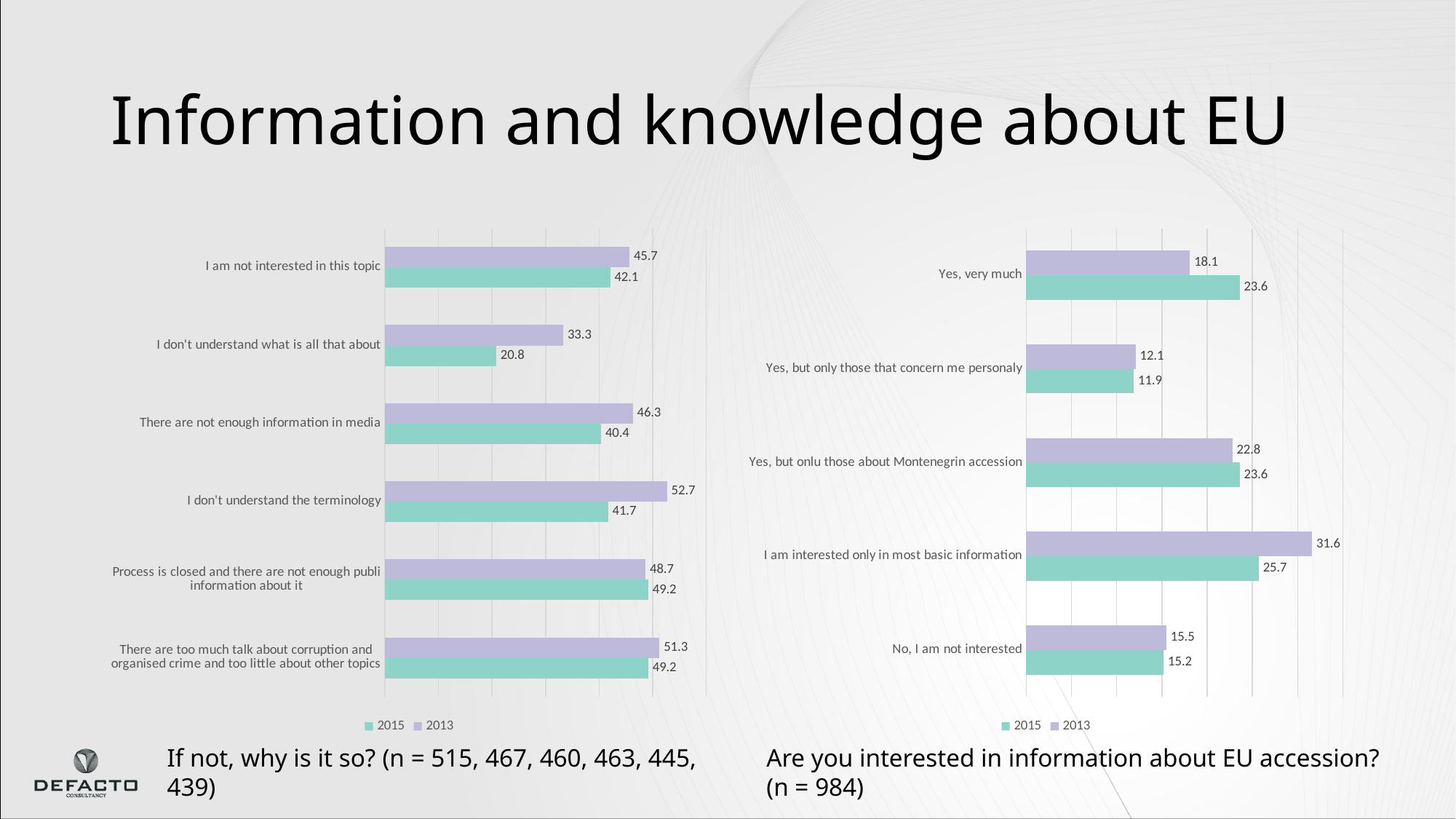
In the left chart (If not, why is it so?), which category has the lowest 2015 value? I don't understand what is all that about In the right chart (Are you interested in information about EU accession?), what is the 2015 value for "No, I am not interested"? 15.2 In the left chart (If not, why is it so?), what is the 2013 value for "I don't understand the terminology"? 52.7 How many series does the legend of the right chart (Are you interested in information about EU accession?) list? 2 In the right chart (Are you interested in information about EU accession?), which is larger for "Yes, very much": the 2013 value or the 2015 value? 2015 In the left chart (If not, why is it so?), how many categories are shown? 6 In the left chart (If not, why is it so?), what is the 2015 value for "I don't understand what is all that about"? 20.8 In the right chart (Are you interested in information about EU accession?), what is the difference between the 2013 and 2015 values for "I am interested only in most basic information"? 5.9 In the left chart (If not, why is it so?), which category has the highest 2013 value? I don't understand the terminology What type of chart is the left chart (If not, why is it so?)? Bar chart In the right chart (Are you interested in information about EU accession?), what is the 2013 value for "I am interested only in most basic information"? 31.6 In the left chart (If not, why is it so?), what is the difference between the 2013 and 2015 values for "There are not enough information in media"? 5.9